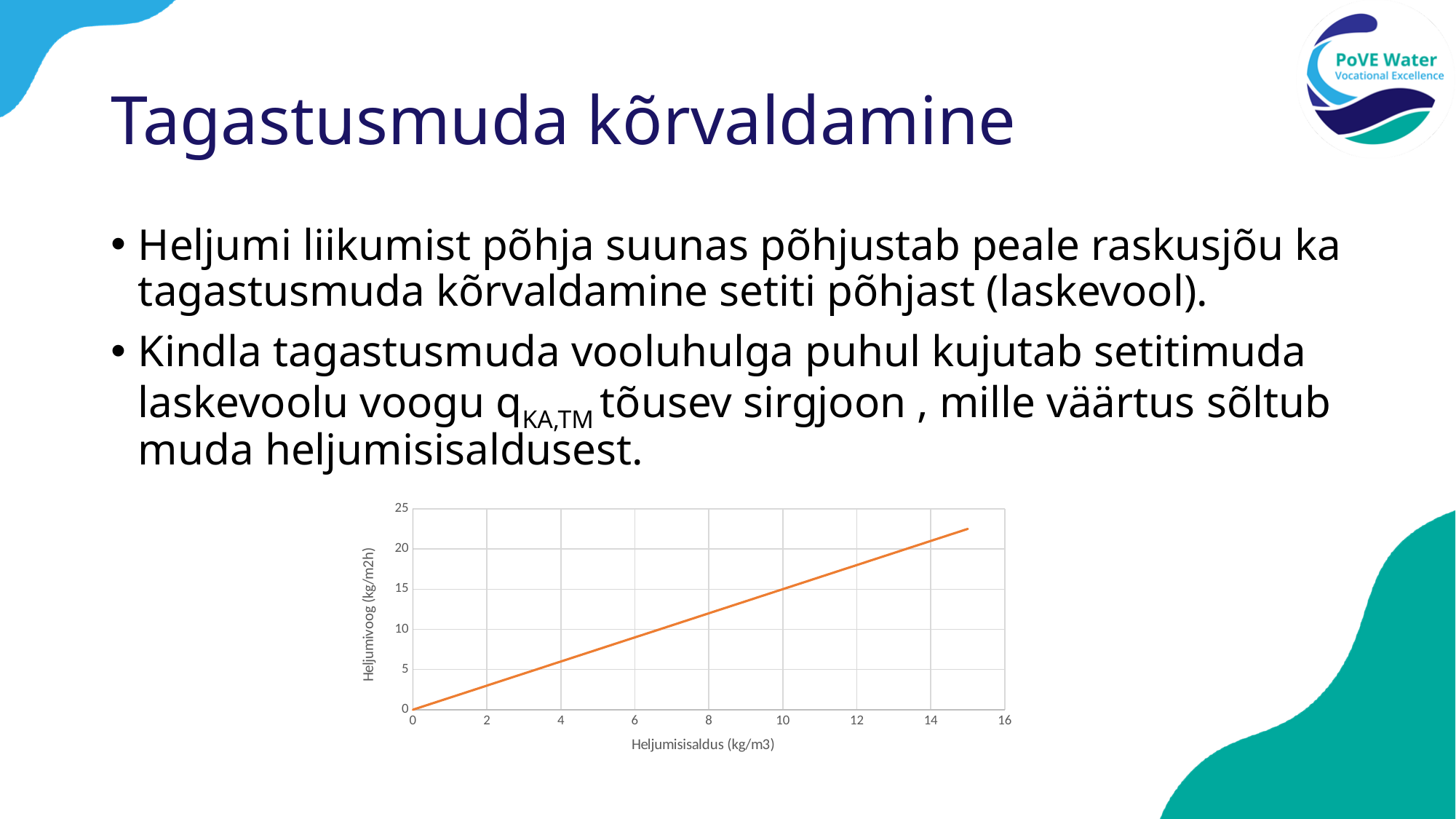
Which is larger, the Heljumivoog value at a Heljumisisaldus of 6 kg/m3 or at 12 kg/m3? 12 kg/m3 Is the Heljumivoog value at a Heljumisisaldus of 14 kg/m3 greater or less than 20? greater Is the Heljumivoog value at a Heljumisisaldus of 2 kg/m3 greater or less than 5? less Is the Heljumivoog value at a Heljumisisaldus of 12 kg/m3 greater or less than 20? less What is the title of the x axis of the chart? Heljumisisaldus (kg/m3) What is the title of the y axis of the chart? Heljumivoog (kg/m2h) Does the Heljumivoog value rise or fall as Heljumisisaldus increases along the x axis? rise What kind of chart is shown on the slide? line chart What is the Heljumivoog value where the line starts at a Heljumisisaldus of 0 kg/m3? 0